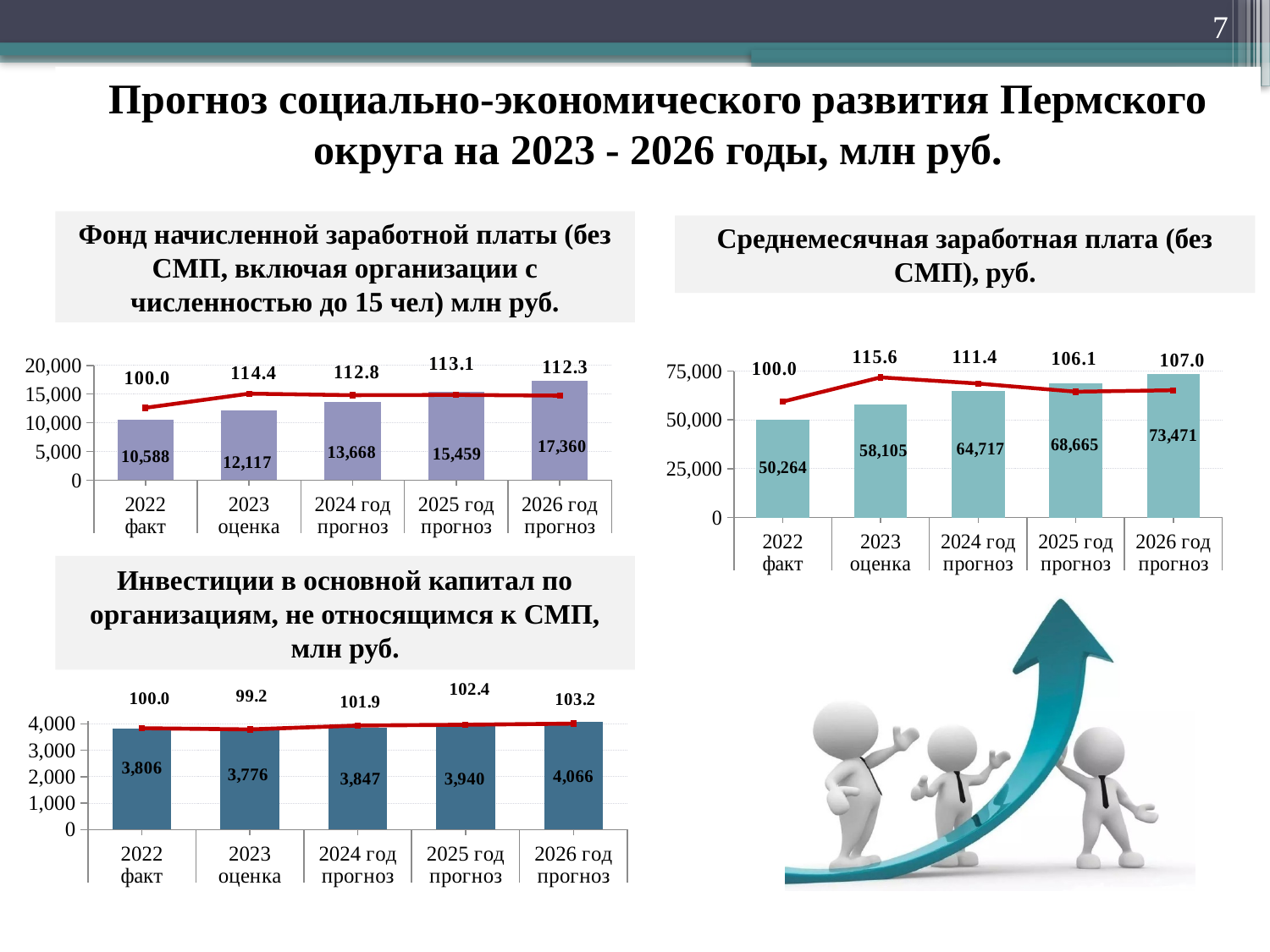
In the chart 'Инвестиции в основной капитал', do the bar values rise or fall from 2023 оценка to 2026 год прогноз? rise In the chart 'Фонд начисленной заработной платы', what is the bar value for 2024 год прогноз? 13,668 In the chart 'Среднемесячная заработная плата', what is the bar value for 2025 год прогноз? 68,665 In the chart 'Среднемесячная заработная плата', which category has the lowest bar value? 2022 факт In the chart 'Среднемесячная заработная плата', what is the line value shown above the 2023 оценка bar? 115.6 In the chart 'Фонд начисленной заработной платы', which category has the highest bar value? 2026 год прогноз In the chart 'Инвестиции в основной капитал', which is larger: the bar value for 2022 факт or for 2023 оценка? 2022 факт In the chart 'Фонд начисленной заработной платы', what is the line value shown above the 2023 оценка bar? 114.4 In the chart 'Среднемесячная заработная плата', is the bar value for 2026 год прогноз greater or less than 50,000? greater In the chart 'Фонд начисленной заработной платы', what is the difference between the bar values for 2026 год прогноз and 2022 факт? 6,772 In the chart 'Инвестиции в основной капитал', how many categories are shown on the x axis? 5 In the chart 'Инвестиции в основной капитал', what is the bar value for 2023 оценка? 3,776